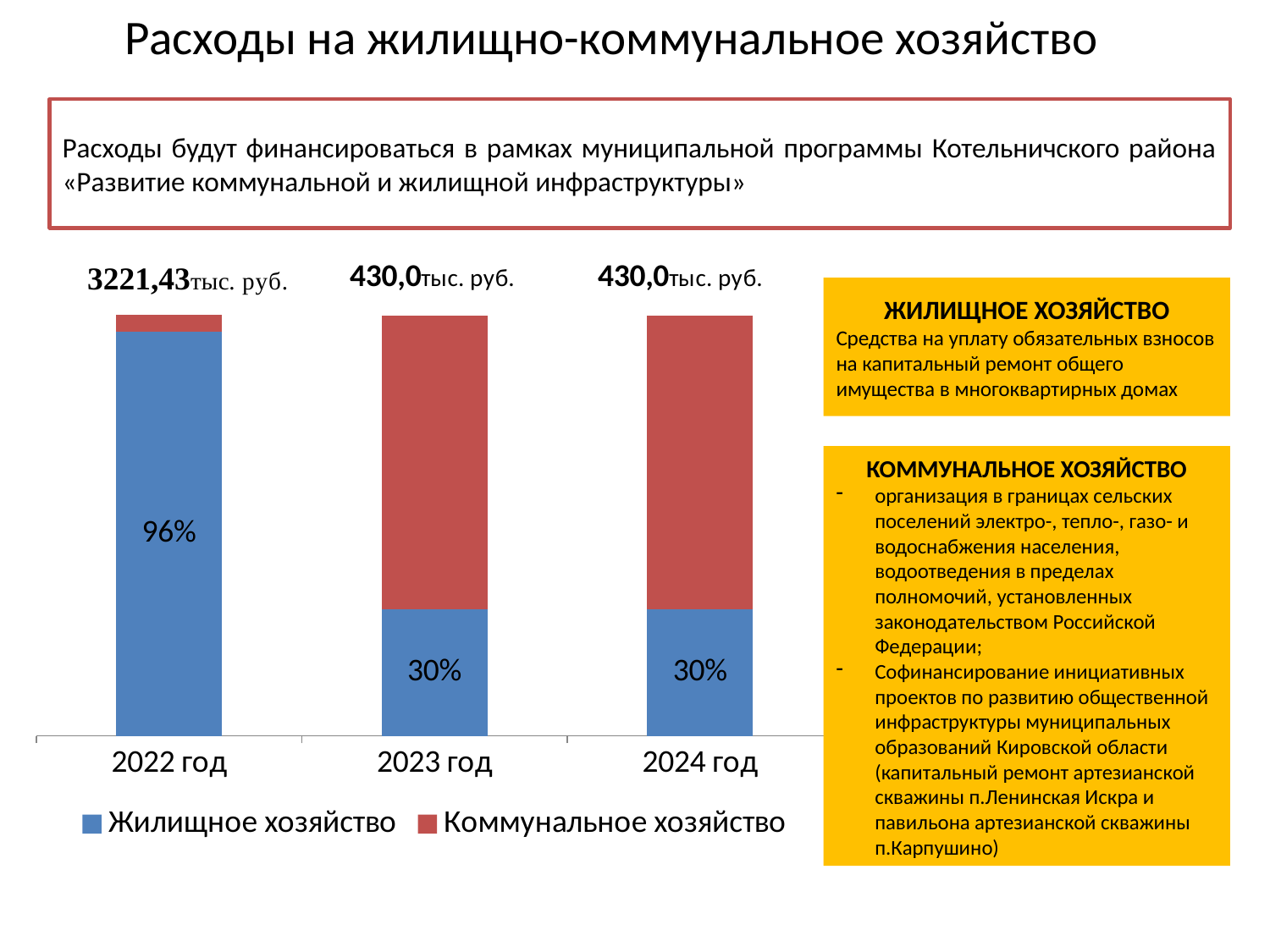
How many series does the chart legend list? 2 How many years are shown on the x axis of the chart? 3 What percentage is shown for Жилищное хозяйство in 2023 год? 30% What percentage is shown for Жилищное хозяйство in 2022 год? 96% What is the difference between the total amounts printed for 2022 год and 2024 год? 2791,43 тыс. руб. What kind of chart is shown on the slide? Stacked bar chart What percentage is shown for Жилищное хозяйство in 2024 год? 30% What total amount is printed above the bar for 2023 год? 430,0 тыс. руб. In 2023 год, which series takes the larger part of the bar, Жилищное хозяйство or Коммунальное хозяйство? Коммунальное хозяйство What total amount is printed above the bar for 2022 год? 3221,43 тыс. руб. Which year has the highest total amount printed above its bar? 2022 год In 2022 год, which series takes the larger part of the bar, Жилищное хозяйство or Коммунальное хозяйство? Жилищное хозяйство